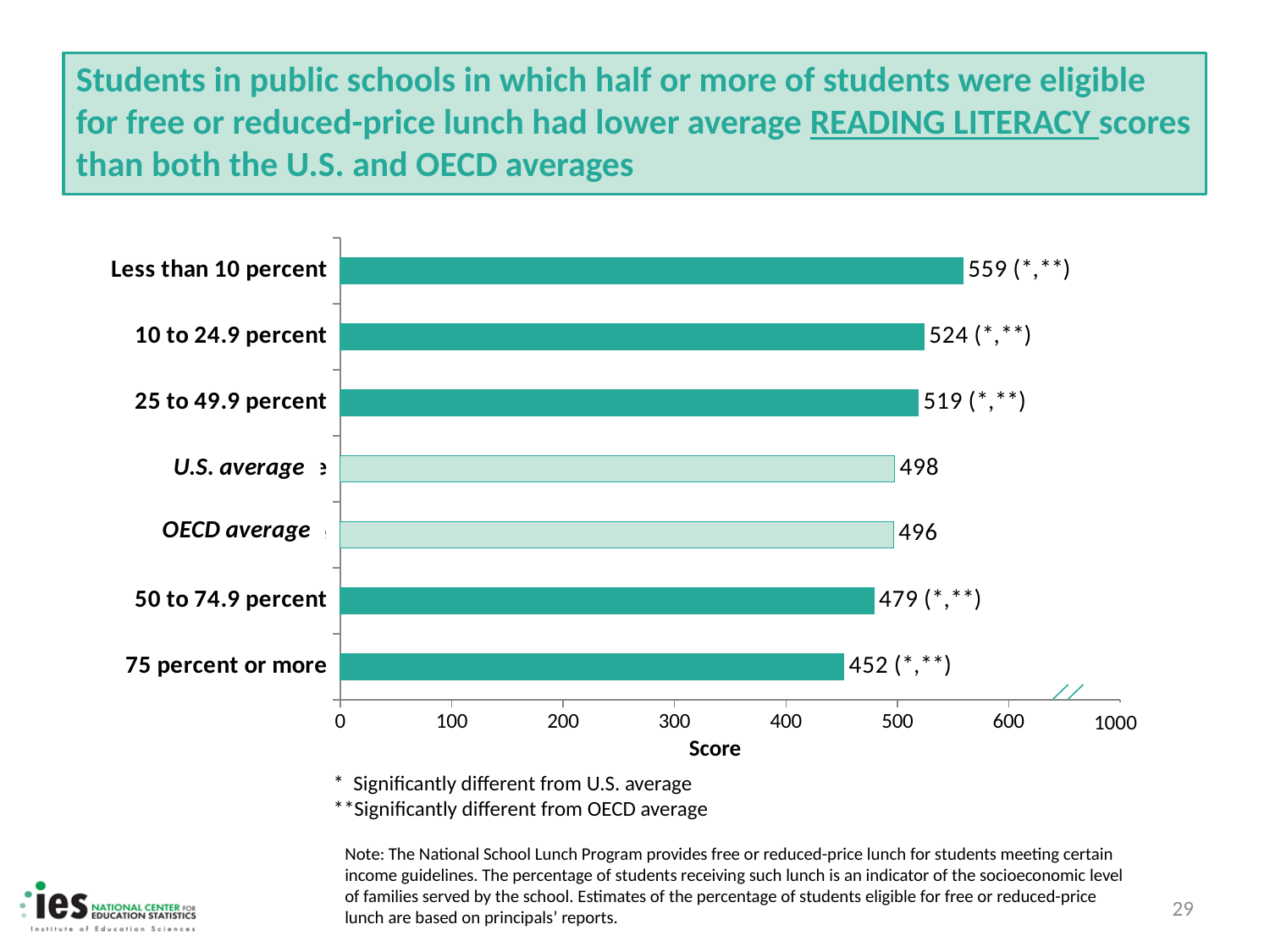
What is the difference between the score for '50 to 74.9 percent' and the U.S. average? 19 What is the average reading literacy score for schools with 75 percent or more of students eligible for free or reduced-price lunch? 452 What is the average reading literacy score for schools with less than 10 percent of students eligible for free or reduced-price lunch? 559 What is the OECD average reading literacy score shown on the chart? 496 What is the U.S. average reading literacy score shown on the chart? 498 Which category has the highest average reading literacy score? Less than 10 percent What is the difference between the scores for the 'Less than 10 percent' and '75 percent or more' categories? 107 How many bars are plotted on the chart? 7 What kind of chart is shown on the slide? Bar chart Which is larger, the score for '10 to 24.9 percent' or the score for '25 to 49.9 percent'? 10 to 24.9 percent What is the label of the horizontal axis? Score Which category has the lowest average reading literacy score? 75 percent or more